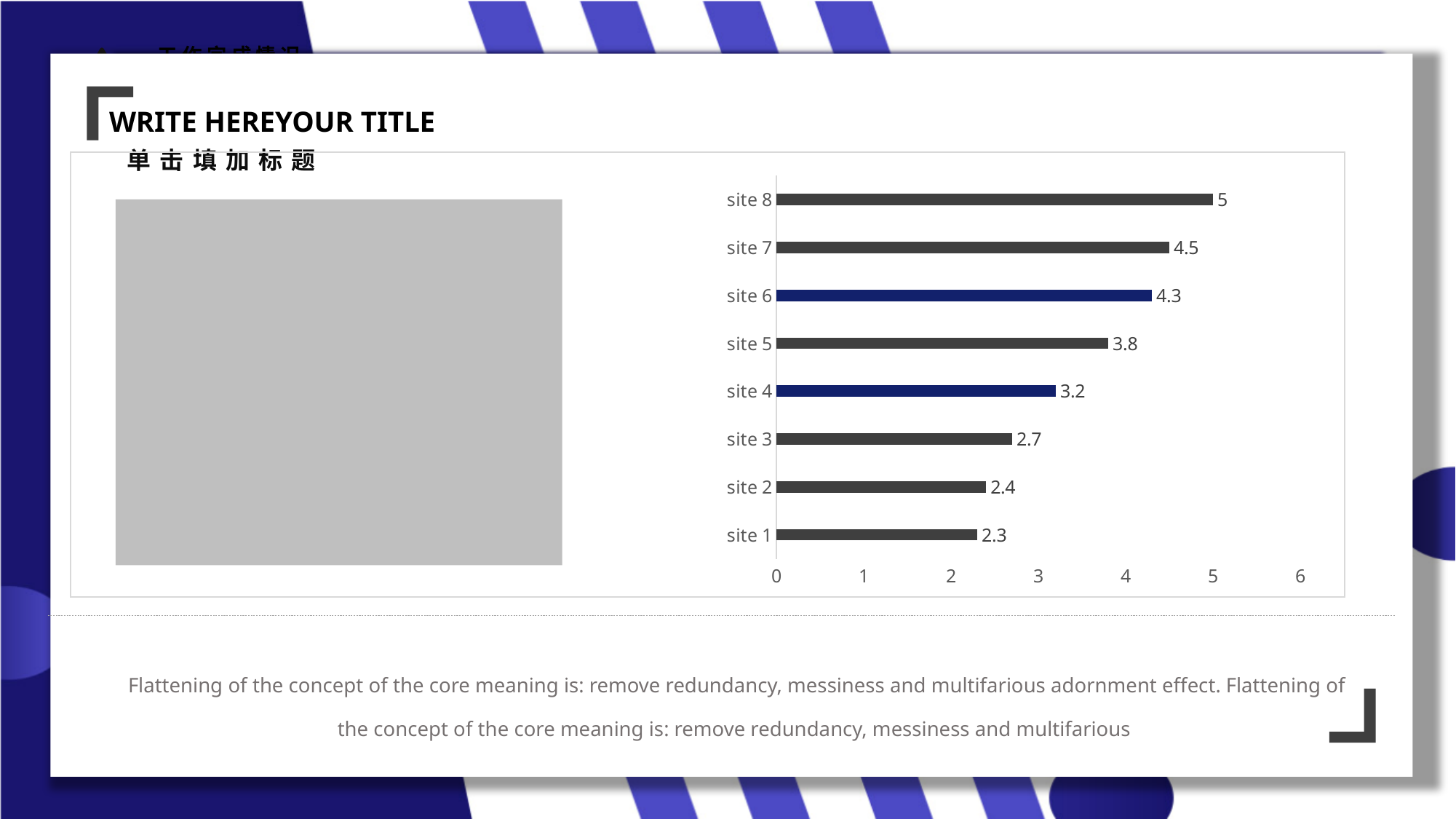
What is the difference between the values for site 8 and site 1? 2.7 How many sites are shown in the chart? 8 What is the value for site 6? 4.3 What kind of chart is shown on the slide? bar chart What is the value for site 5? 3.8 Which site has the highest value? site 8 Which two bars are coloured dark blue instead of grey? site 4 and site 6 What is the difference between the values for site 7 and site 4? 1.3 Is the value for site 4 greater or less than 3? greater Which has a larger value, site 3 or site 5? site 5 Which site has the lowest value? site 1 What is the value for site 2? 2.4